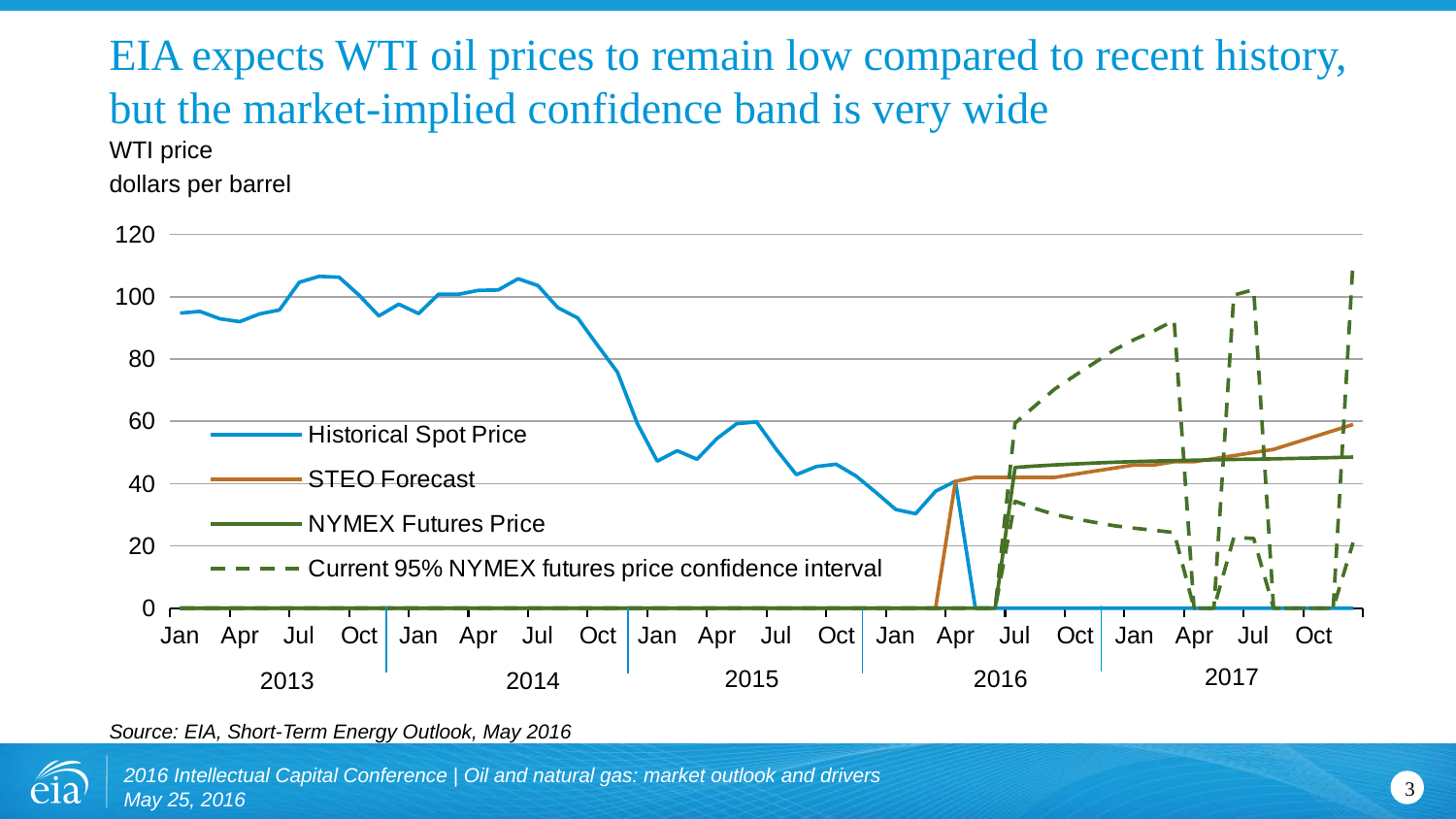
What kind of chart is shown on the slide? line chart Is the Historical Spot Price in Jan 2015 greater or less than 60? less How many series does the legend list? 4 Does the Historical Spot Price rise or fall between Jul 2014 and Jan 2015? fall What unit is the y axis measured in, according to the label above the chart? dollars per barrel Is the NYMEX Futures Price at the end of 2017 greater or less than 60? less Is the Historical Spot Price in Jan 2013 greater or less than 80? greater How many years are labelled along the x axis? 5 At the end of 2017, which is higher: the STEO Forecast or the NYMEX Futures Price? STEO Forecast Which series is drawn with a dashed line? Current 95% NYMEX futures price confidence interval